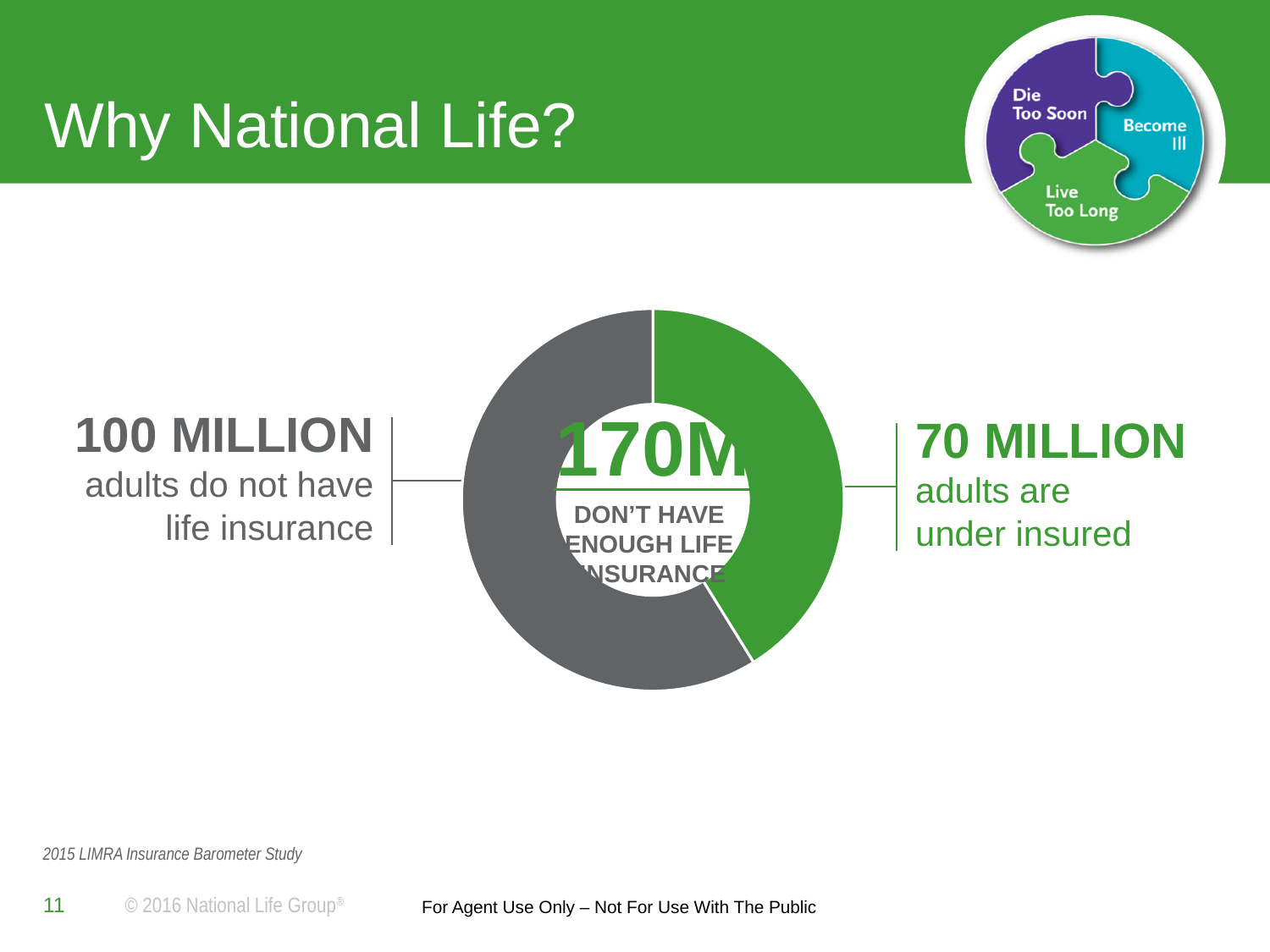
How many adults are under insured, according to the chart? 70 MILLION What does the text in the centre of the donut chart say the 170M figure represents? Don't have enough life insurance What kind of chart is shown on the slide? Pie chart (donut) How many segments does the donut chart have? 2 Which segment of the donut chart is larger: adults who do not have life insurance or adults who are under insured? Adults who do not have life insurance Which group represents the largest segment of the donut chart? Adults who do not have life insurance (100 MILLION) What is the difference between the number of adults who do not have life insurance and the number who are under insured? 30 million What colour is the segment representing adults who are under insured? Green What total figure is printed in the centre of the donut chart? 170M Which group represents the smallest segment of the donut chart? Adults who are under insured (70 MILLION) Is the number of adults who are under insured greater or less than 100 million? less How many adults do not have life insurance, according to the chart? 100 MILLION